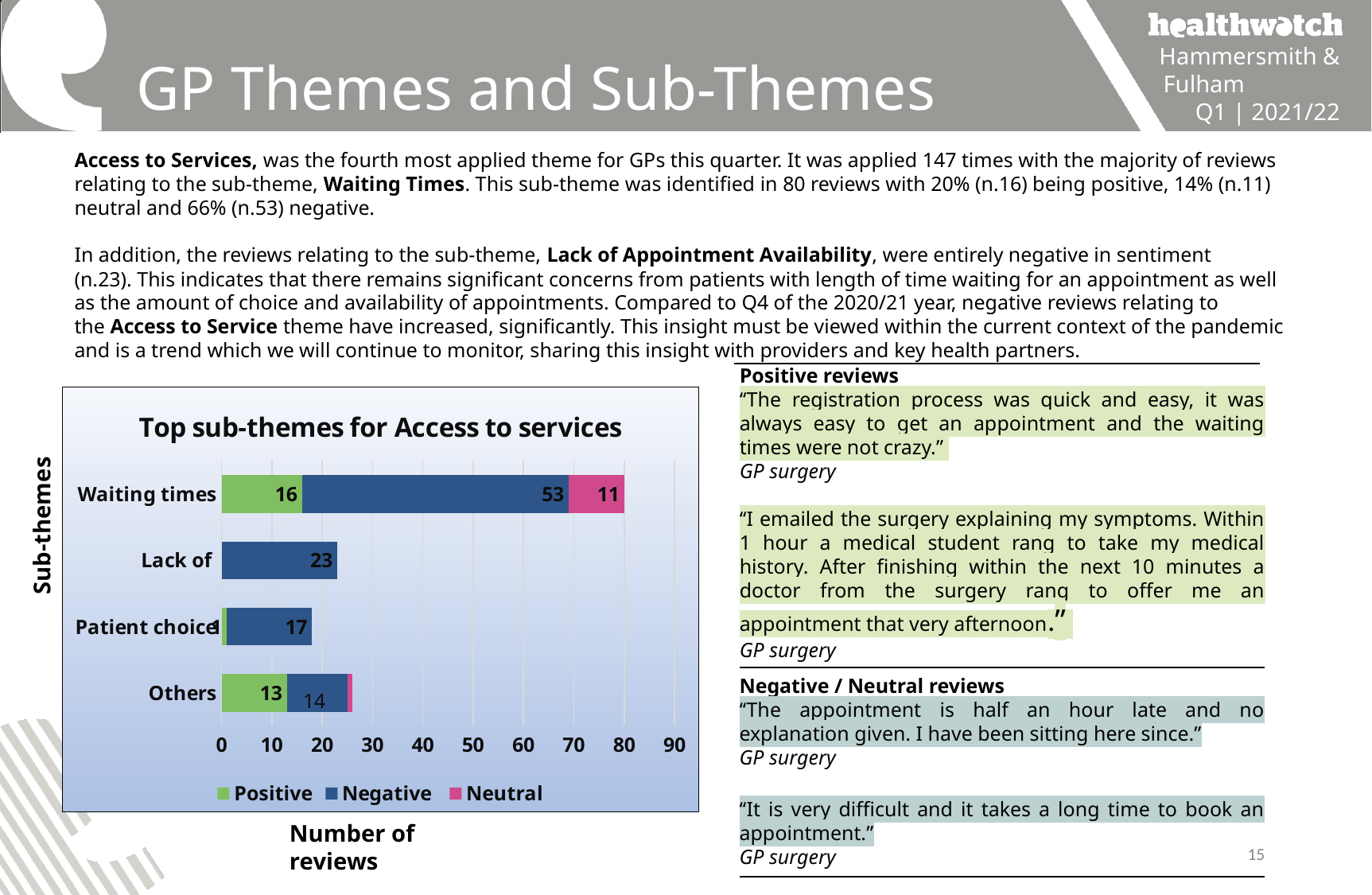
In the chart 'Top sub-themes for Access to services', which sub-theme has the highest Negative value? Waiting times What kind of chart is 'Top sub-themes for Access to services'? Stacked bar chart In the chart 'Top sub-themes for Access to services', what is the total number of reviews for Waiting times across all three series? 80 In the chart 'Top sub-themes for Access to services', what is the Negative value for Patient choice? 17 In the chart 'Top sub-themes for Access to services', what is the difference between the Negative value for Waiting times and the Negative value for 'Lack of'? 30 In the chart 'Top sub-themes for Access to services', what is the Negative value for Waiting times? 53 In the chart 'Top sub-themes for Access to services', is the Negative value larger for Patient choice or for Others? Patient choice In the chart 'Top sub-themes for Access to services', what is the Negative value for the 'Lack of' sub-theme? 23 In the chart 'Top sub-themes for Access to services', what is the Neutral value for Waiting times? 11 How many series does the legend of the chart 'Top sub-themes for Access to services' list? 3 In the chart 'Top sub-themes for Access to services', what is the Positive value for Others? 13 In the chart 'Top sub-themes for Access to services', what is the Positive value for Waiting times? 16